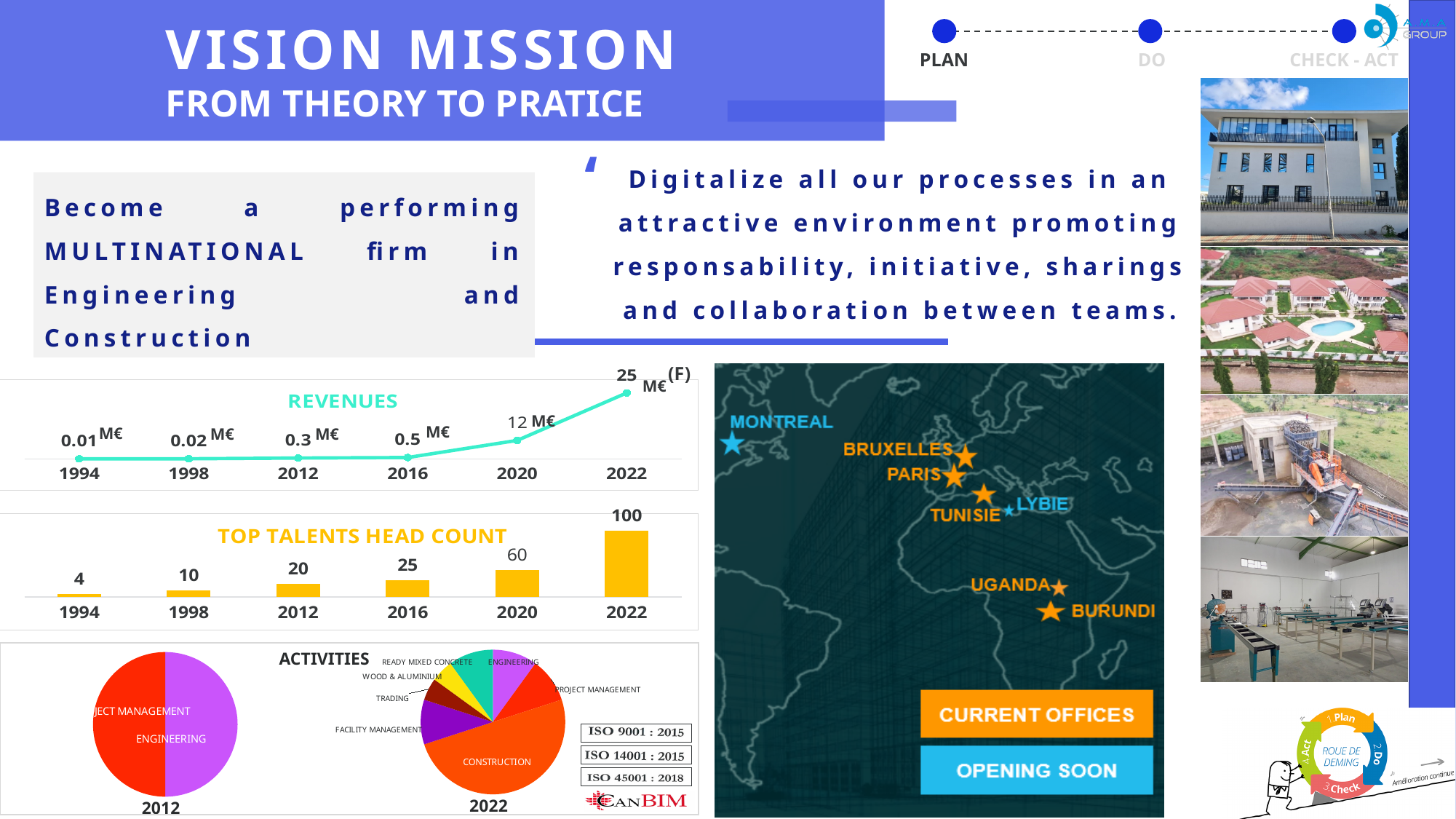
What kind of chart is the REVENUES chart? line chart What kind of chart is the TOP TALENTS HEAD COUNT chart? bar chart In the REVENUES chart, what is the revenue value for 2022? 25 M€ In the REVENUES chart, do the values rise or fall from 1994 to 2022? rise How many years are shown in the TOP TALENTS HEAD COUNT chart? 6 In the ACTIVITIES pie chart for 2022, which activity has the largest slice? CONSTRUCTION In the TOP TALENTS HEAD COUNT chart, what is the head count for 1994? 4 In the TOP TALENTS HEAD COUNT chart, which year has the highest head count? 2022 In the REVENUES chart, what is the revenue value for 2020? 12 M€ In the TOP TALENTS HEAD COUNT chart, what is the difference between the head count in 2022 and in 2020? 40 In the TOP TALENTS HEAD COUNT chart, what is the head count for 2022? 100 In the TOP TALENTS HEAD COUNT chart, which is larger, the head count for 2016 or for 2012? 2016